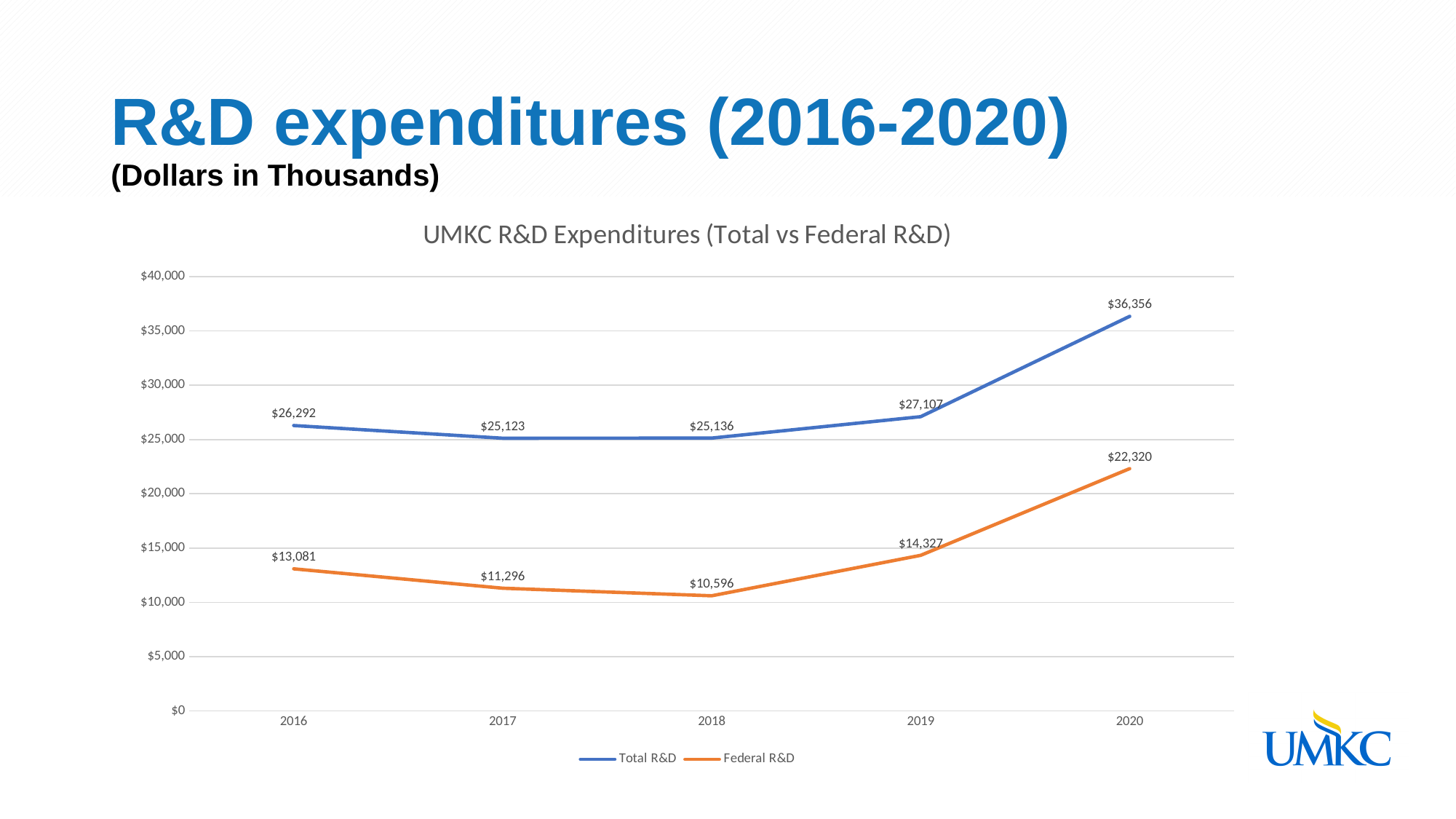
What is the Federal R&D value for 2018? $10,596 How many years are plotted on the x axis? 5 In which year is Federal R&D lowest? 2018 Which is larger, Federal R&D in 2016 or Federal R&D in 2019? Federal R&D in 2019 How many series does the legend list? 2 What kind of chart is shown? Line chart What is the Total R&D value for 2020? $36,356 In which year is Total R&D highest? 2020 Is the Total R&D value for 2019 greater or less than $25,000? greater What is the difference between Total R&D and Federal R&D in 2020? $14,036 What is the title of the chart? UMKC R&D Expenditures (Total vs Federal R&D) What is the Total R&D value for 2017? $25,123